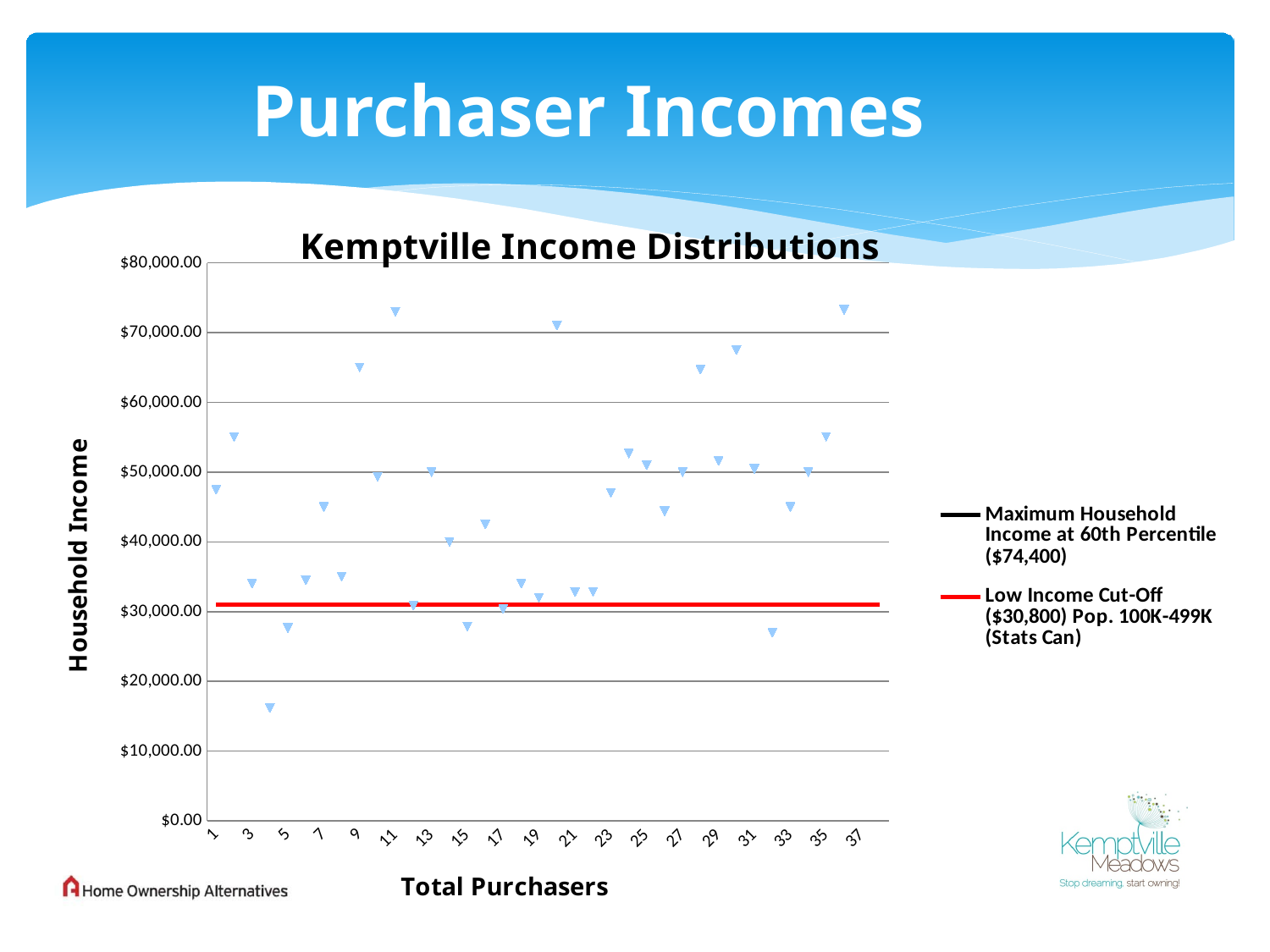
Is the household income for purchaser 4 greater or less than $20,000.00? less What is the label on the x axis of the chart? Total Purchasers Is the household income for purchaser 9 greater or less than $60,000.00? greater What value does the legend give for the Maximum Household Income at 60th Percentile? $74,400 How many entries does the chart's legend list? 2 Is the household income for purchaser 20 greater or less than $70,000.00? greater What is the title of the chart? Kemptville Income Distributions What kind of chart is shown on the slide? Scatter chart Which purchaser number has the lowest household income on the chart? 4 Which has the higher household income, purchaser 2 or purchaser 3? Purchaser 2 What value does the legend give for the Low Income Cut-Off line? $30,800